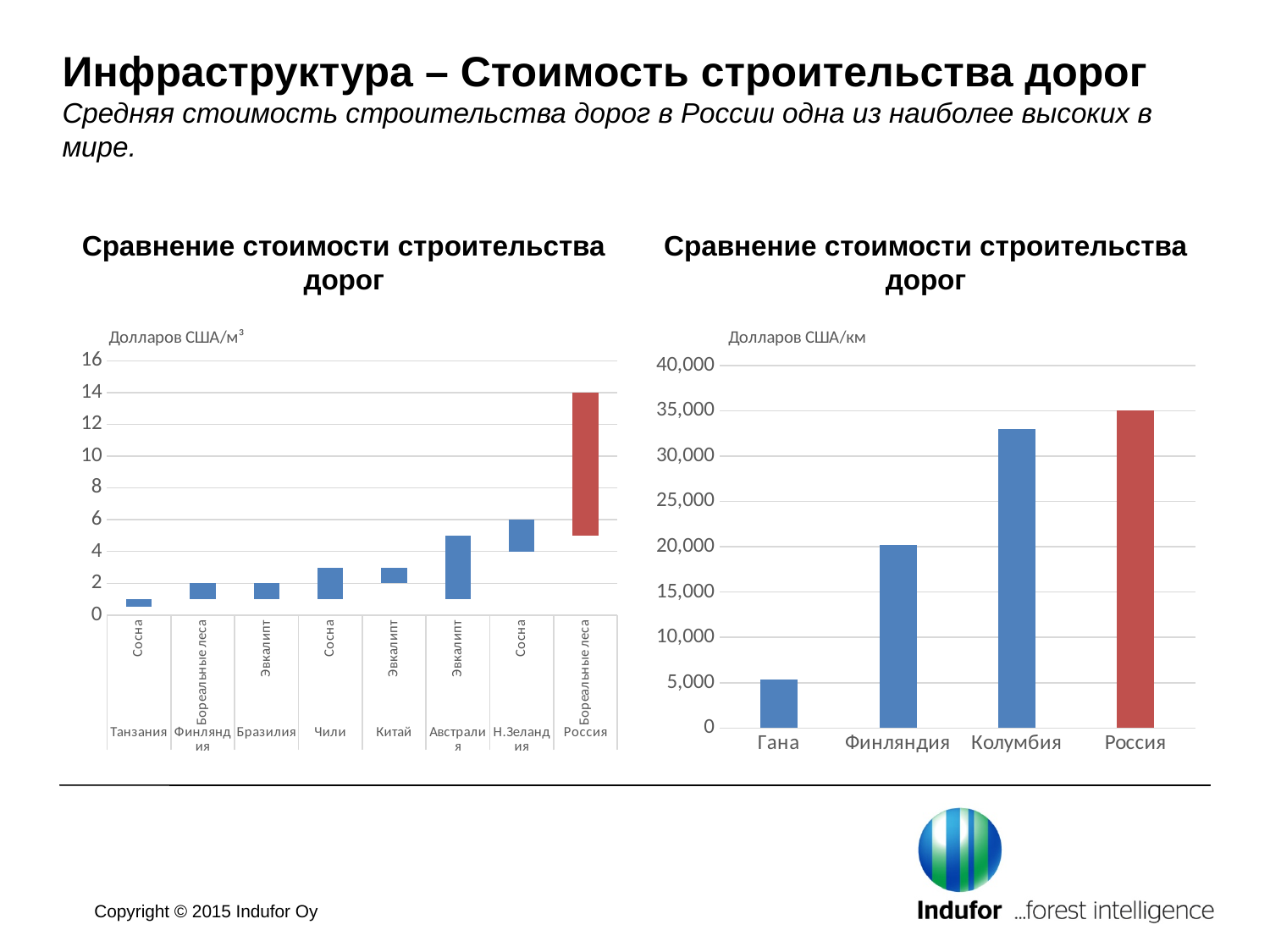
On the left chart (Долларов США/м³), which is larger, the value for Н.Зеландия or the value for Чили? Н.Зеландия What type of chart is the right chart (Долларов США/км)? Bar chart On the right chart (Долларов США/км), how many countries are shown? 4 On the left chart (Долларов США/м³), is the value for Танзания greater or less than 2? less On the right chart (Долларов США/км), which country has the lowest value? Гана On the right chart (Долларов США/км), is the value for Колумбия greater or less than 30,000? greater On the right chart (Долларов США/км), which country has the highest value? Россия On the left chart (Долларов США/м³), how many countries are shown on the x axis? 8 On the right chart (Долларов США/км), which is larger, the value for Колумбия or the value for Финляндия? Колумбия On the left chart (Долларов США/м³), is the top of the bar for Россия greater or less than 10? greater On the left chart (Долларов США/м³), which country has the lowest value? Танзания On the left chart (Долларов США/м³), which country has the highest value? Россия